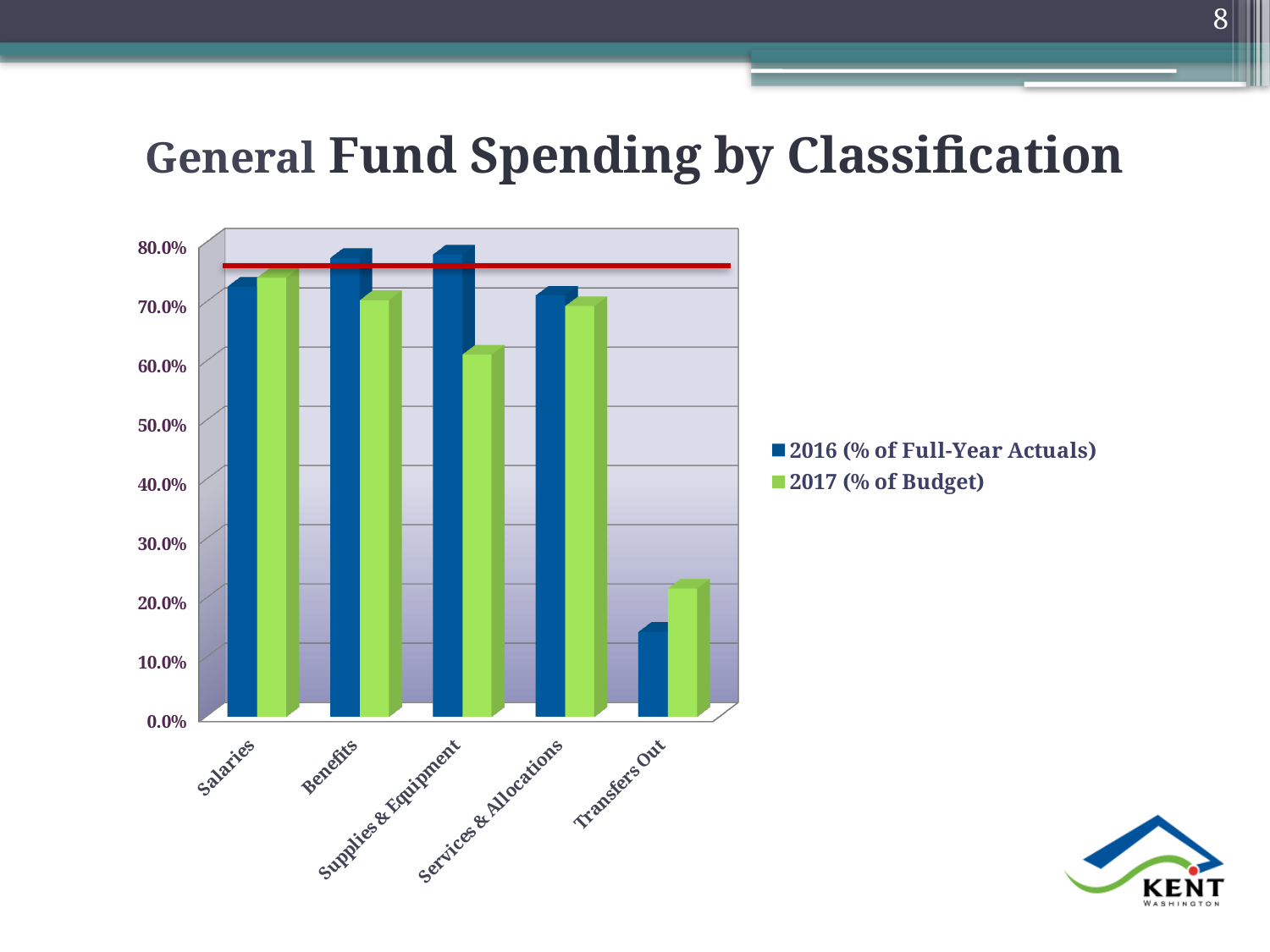
Is the 2017 (% of Budget) value for Supplies & Equipment greater or less than 70.0%? less For Transfers Out, which series has the larger value: 2016 (% of Full-Year Actuals) or 2017 (% of Budget)? 2017 (% of Budget) For Supplies & Equipment, which series has the larger value: 2016 (% of Full-Year Actuals) or 2017 (% of Budget)? 2016 (% of Full-Year Actuals) How many series does the chart legend list? 2 What kind of chart is shown on the slide? bar chart Is the 2016 (% of Full-Year Actuals) value for Benefits greater or less than 70.0%? greater Which category has the lowest value for the 2016 (% of Full-Year Actuals) series? Transfers Out What is the title of the slide containing the chart? General Fund Spending by Classification Is the 2016 (% of Full-Year Actuals) value for Transfers Out greater or less than 20.0%? less Which colour represents the 2017 (% of Budget) series in the chart? green Which category has the lowest value for the 2017 (% of Budget) series? Transfers Out How many categories are shown on the x axis of the chart? 5